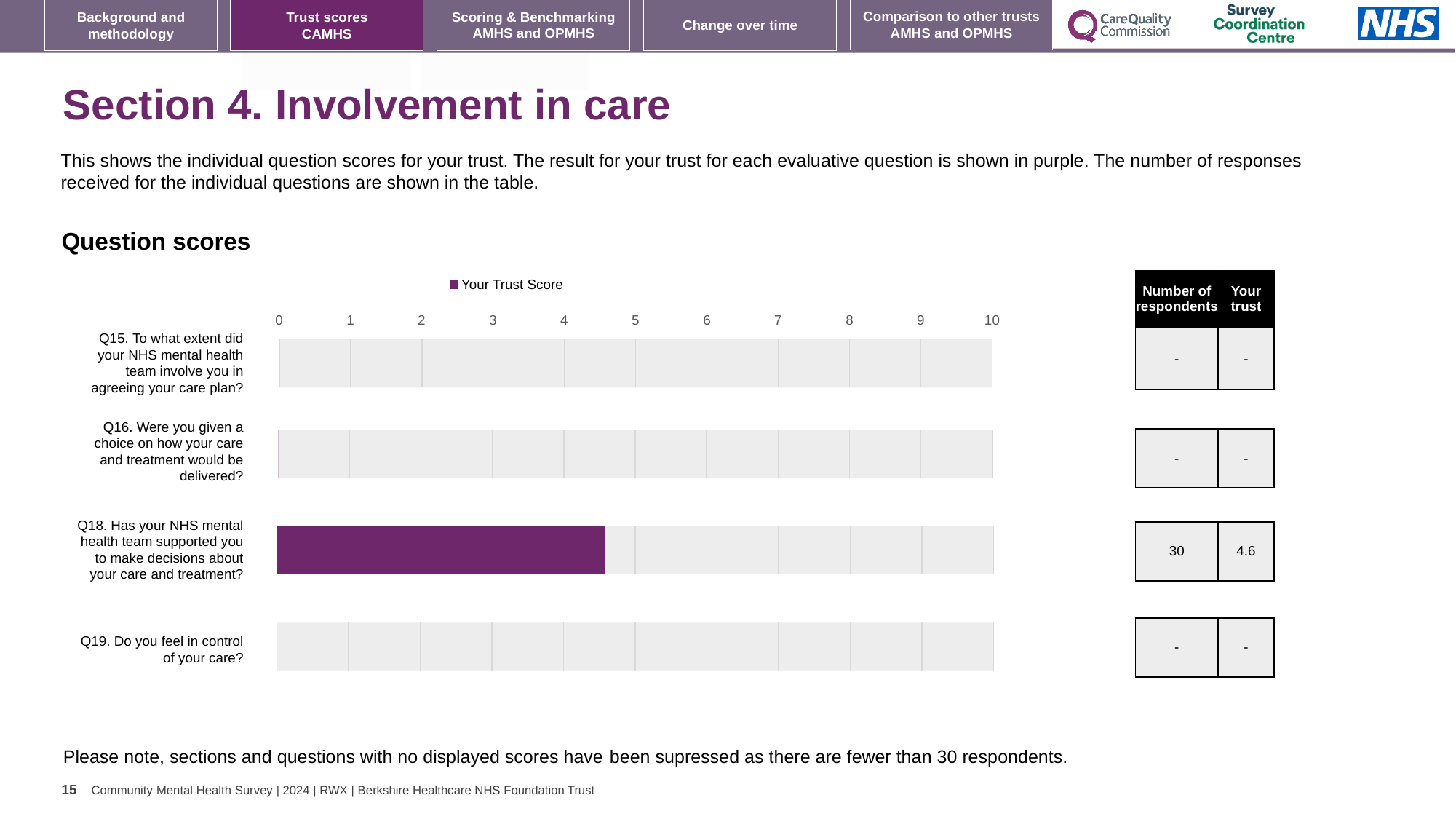
What is the trust score for Q18 (Has your NHS mental health team supported you to make decisions about your care and treatment?)? 4.6 How many series does the chart legend list? 1 Which question is the only one with a displayed score bar on the chart? Q18 What is the number of respondents shown for Q18? 30 What kind of chart is shown under 'Question scores'? bar chart What is the highest value shown on the chart's horizontal axis? 10 Is the trust score for Q18 greater or less than 4? greater How many questions on the chart have no displayed score? 3 How many questions (categories) are listed on the chart's vertical axis? 4 Is the trust score for Q18 greater or less than 5? less What is the name of the series shown in the chart legend? Your Trust Score